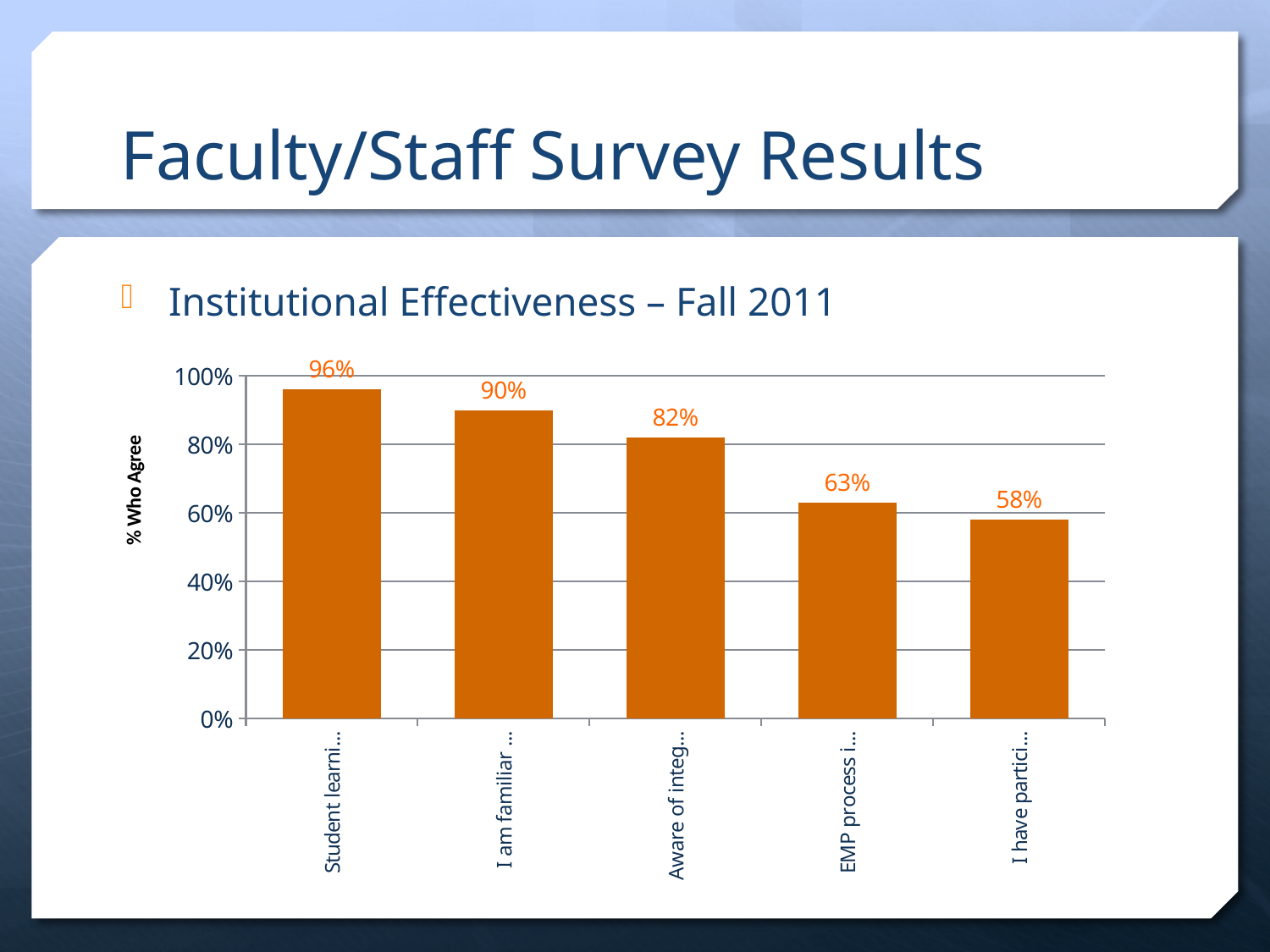
What is the value of the bar labelled "EMP process i..."? 63% How many bars are shown in the chart? 5 What is the value of the bar labelled "Aware of integ..."? 82% Do the bar values rise or fall from left to right across the chart? Fall What is the difference between the first bar (96%) and the last bar (58%)? 38% What is the label of the vertical axis of the chart? % Who Agree What type of chart is shown on the slide? Bar chart Which is larger: the value for "I am familiar ..." or the value for "EMP process i..."? I am familiar ... (90%) Which bar has the highest value in the chart? Student learni... (96%) What is the value of the last bar (labelled "I have partici...")? 58% What is the value of the first bar (labelled "Student learni...") in the chart? 96% Which bar has the lowest value in the chart? I have partici... (58%)